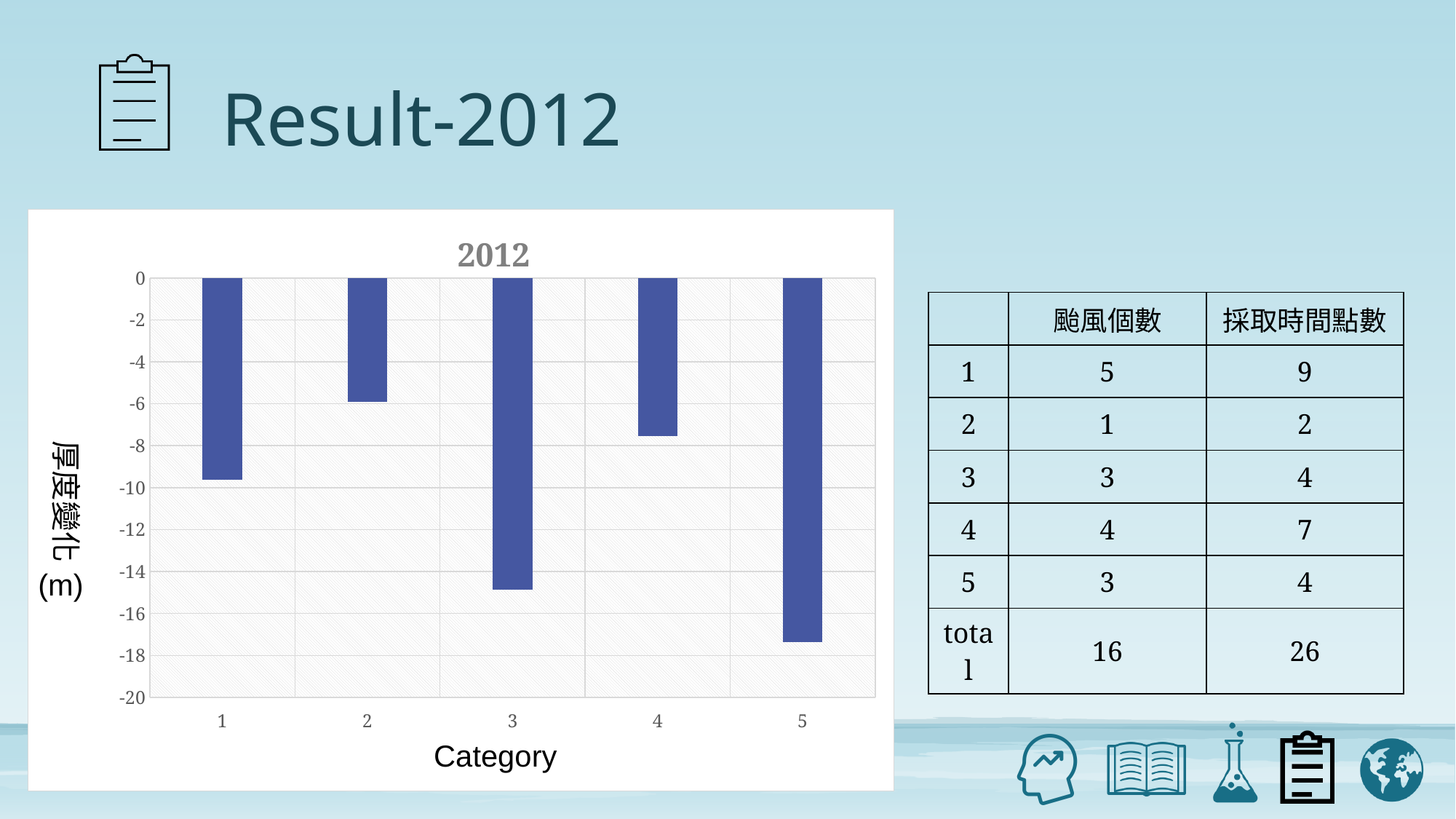
What kind of chart is shown on the slide? bar chart What is the label of the x axis of the chart? Category What is the title of the chart? 2012 Is the value for category 2 greater or less than -8? greater How many categories are plotted on the x axis of the chart? 5 Which has the more negative value, category 2 or category 4? category 4 Is the value for category 5 greater or less than -16? less Which category has the most negative value (the longest bar) in the chart? 5 Which has the more negative value, category 1 or category 3? category 3 Is the value for category 1 greater or less than -8? less Which category has the value closest to zero (the shortest bar) in the chart? 2